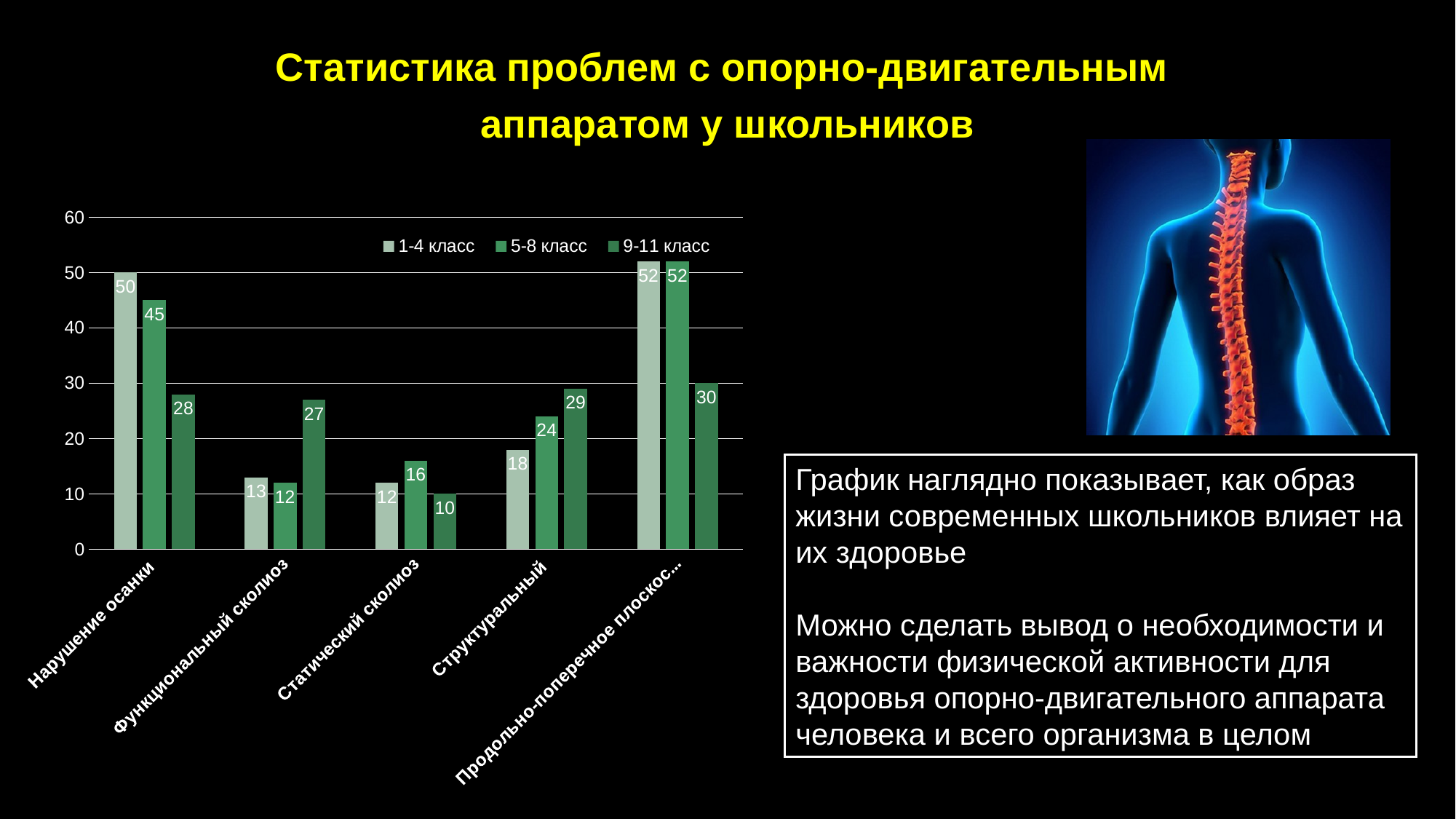
What is the difference between the 9-11 класс and 5-8 класс values in the Структуральный category? 5 What is the difference between the 1-4 класс and 9-11 класс values in the Нарушение осанки category? 22 What is the value for 1-4 класс in the Нарушение осанки category? 50 What is the value for 9-11 класс in the Функциональный сколиоз category? 27 How many categories are shown on the x axis of the chart? 5 In the Структуральный category, which series has the lowest value? 1-4 класс How many series does the legend list? 3 What kind of chart is shown on the slide? Bar chart For the 9-11 класс series, which is larger: Функциональный сколиоз or Статический сколиоз? Функциональный сколиоз What is the value for 5-8 класс in the Статический сколиоз category? 16 In the Нарушение осанки category, which series has the highest value? 1-4 класс What are the three series listed in the chart legend? 1-4 класс, 5-8 класс, 9-11 класс